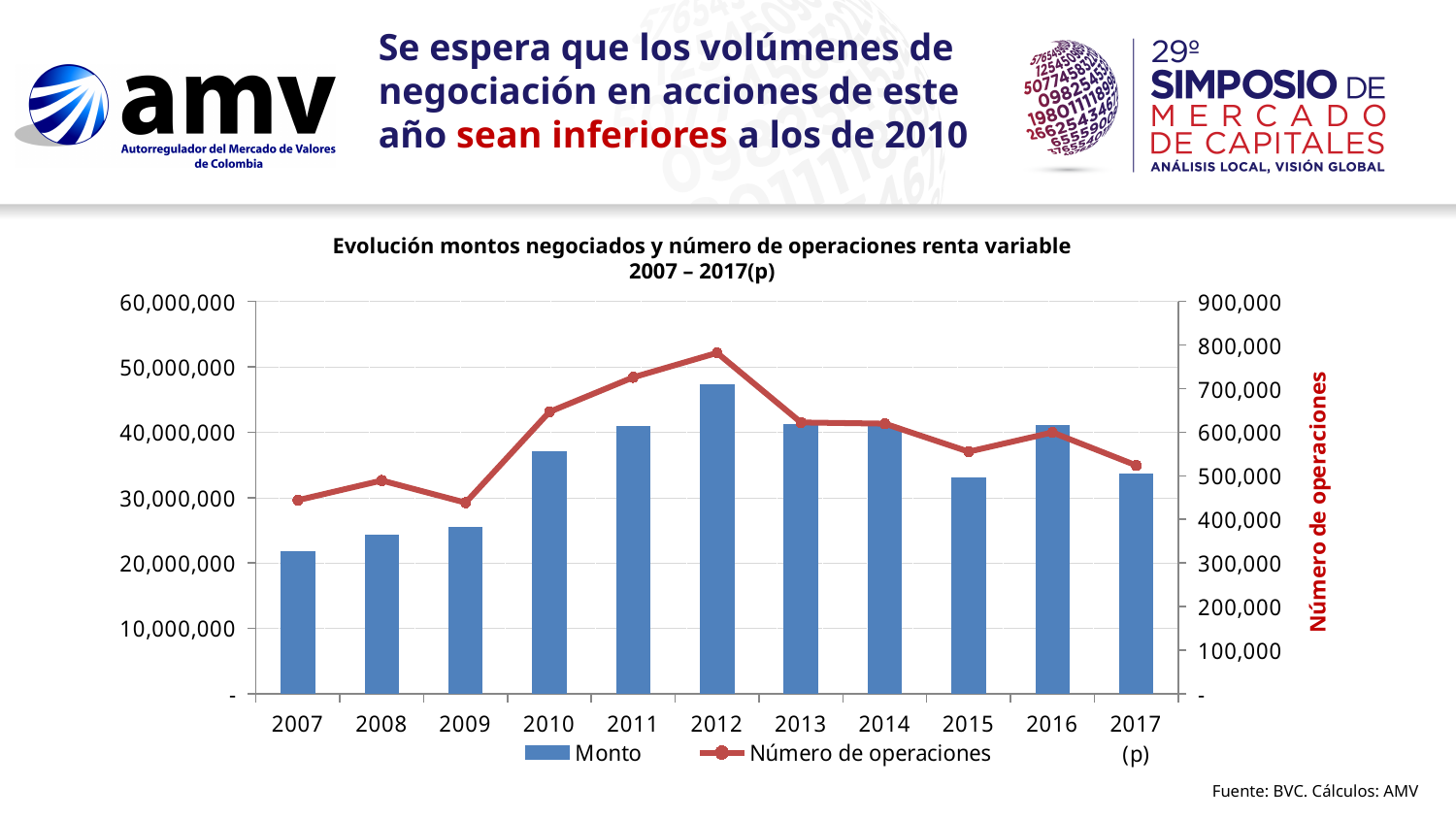
Is the Número de operaciones value for 2012 greater or less than 700,000? greater What type of chart is shown on the slide? A combined bar and line chart Which year has the larger Monto bar, 2012 or 2015? 2012 How many series does the chart legend list? 2 Is the Monto value for 2015 greater or less than 40,000,000? less In which year does the Número de operaciones line reach its peak? 2012 How many years (categories) are shown on the x axis of the chart? 11 Does the Monto series rise or fall from 2007 to 2012? Rise Which year has the lowest Monto bar? 2007 Is the Número de operaciones value for 2009 greater or less than 500,000? less Which year has the highest Monto bar? 2012